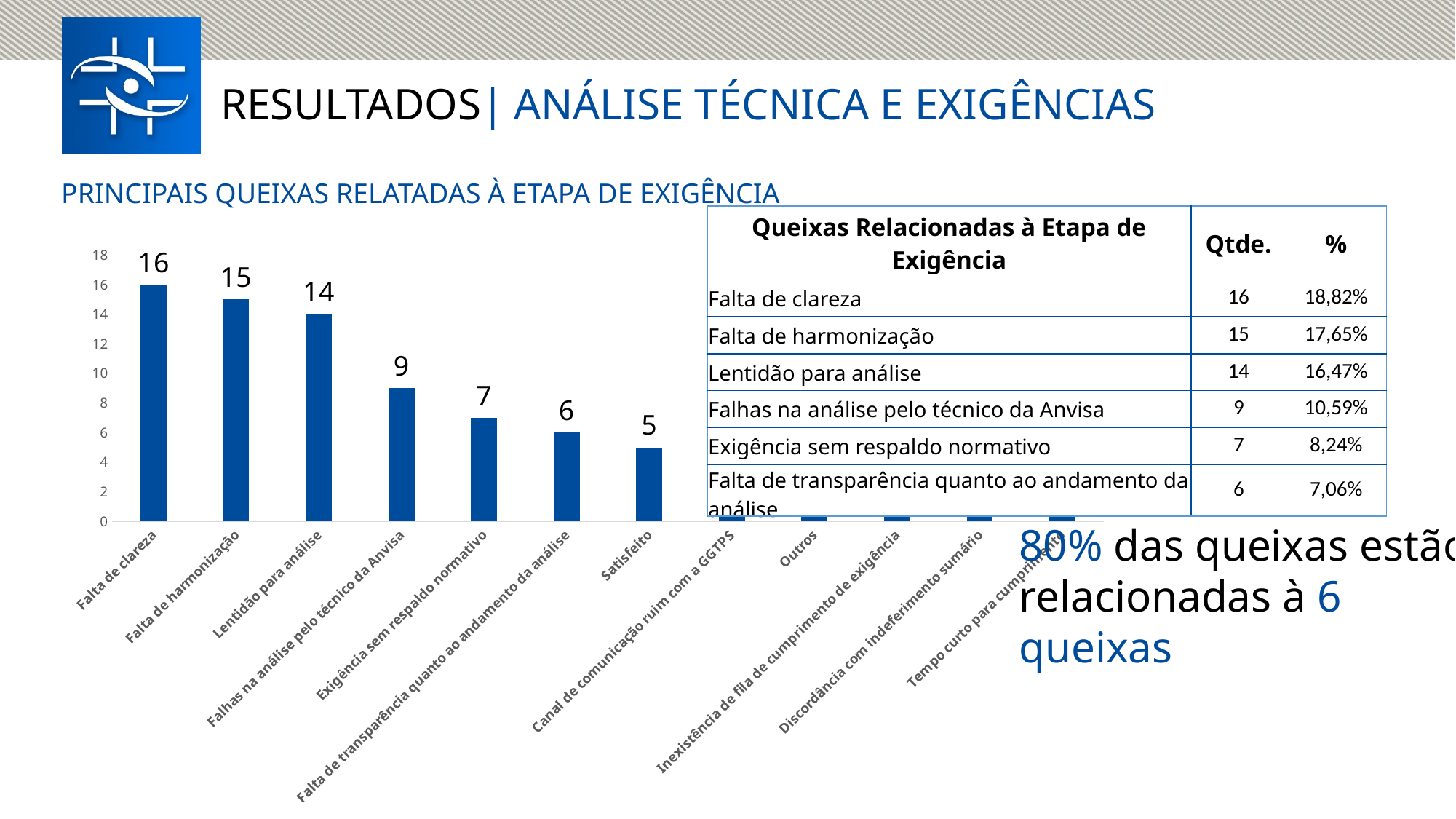
Which is larger, the value for Falta de transparência quanto ao andamento da análise or the value for Satisfeito? Falta de transparência quanto ao andamento da análise What is the value for Satisfeito? 5 What is the difference between the values for Falta de harmonização and Falhas na análise pelo técnico da Anvisa? 6 What is the value for Falta de clareza? 16 What kind of chart is shown on the slide? bar chart What is the value for Lentidão para análise? 14 Do the values rise or fall from left to right along the x axis? fall Which category has the highest value? Falta de clareza How many categories are shown on the x axis of the chart? 12 What is the value for Exigência sem respaldo normativo? 7